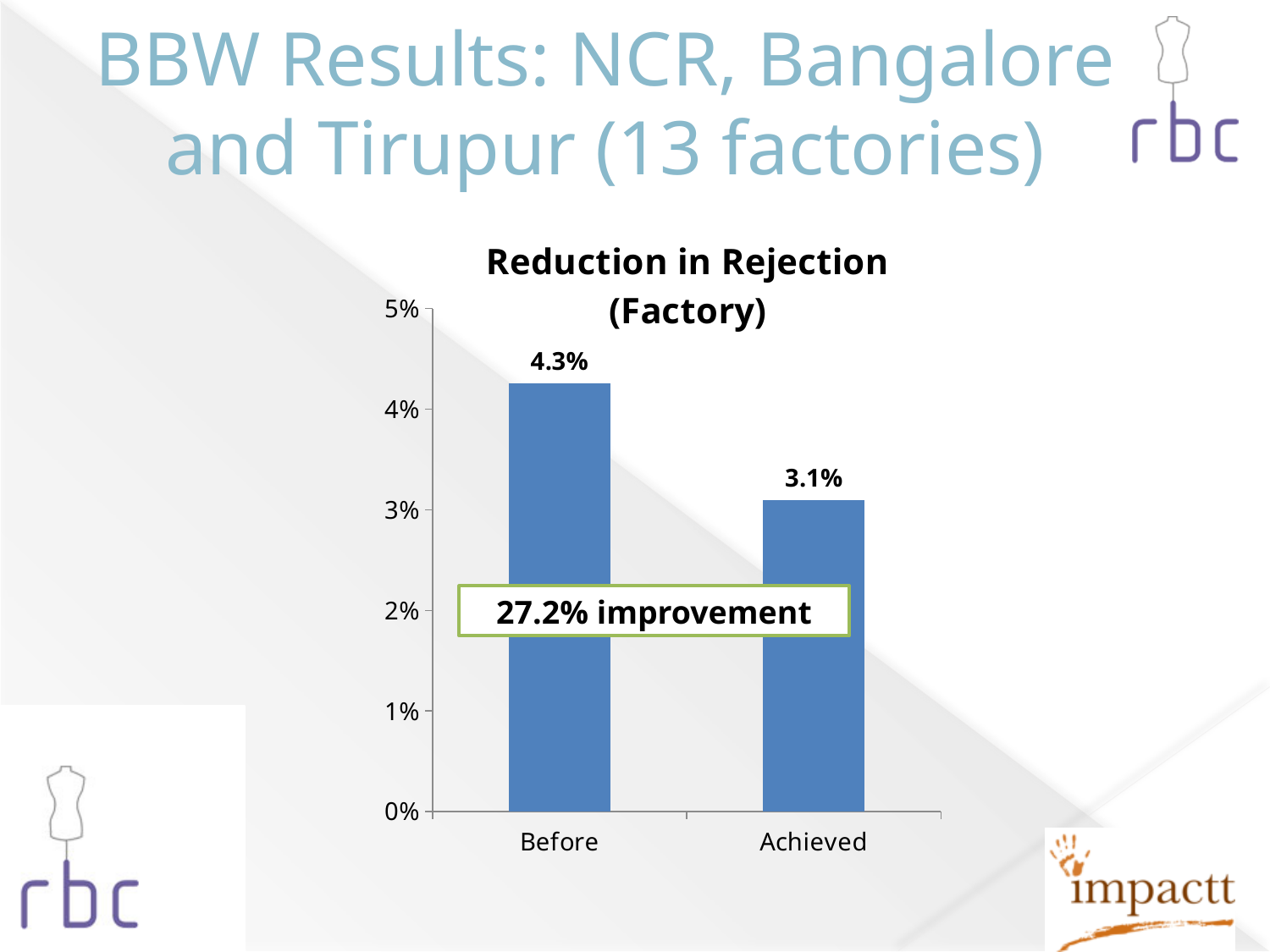
What is the value for Before? 4.3% Which is larger, the value for Before or the value for Achieved? Before What is the difference between the Before and Achieved values? 1.2% What kind of chart is shown? Bar chart How many categories are shown on the x axis? 2 Is the value for Before greater or less than 4%? greater Which category has the lowest value? Achieved Is the value for Achieved greater or less than 3%? greater Do the values rise or fall from Before to Achieved? Fall What is the value for Achieved? 3.1% Which category has the highest value? Before What is the title of the chart? Reduction in Rejection (Factory)